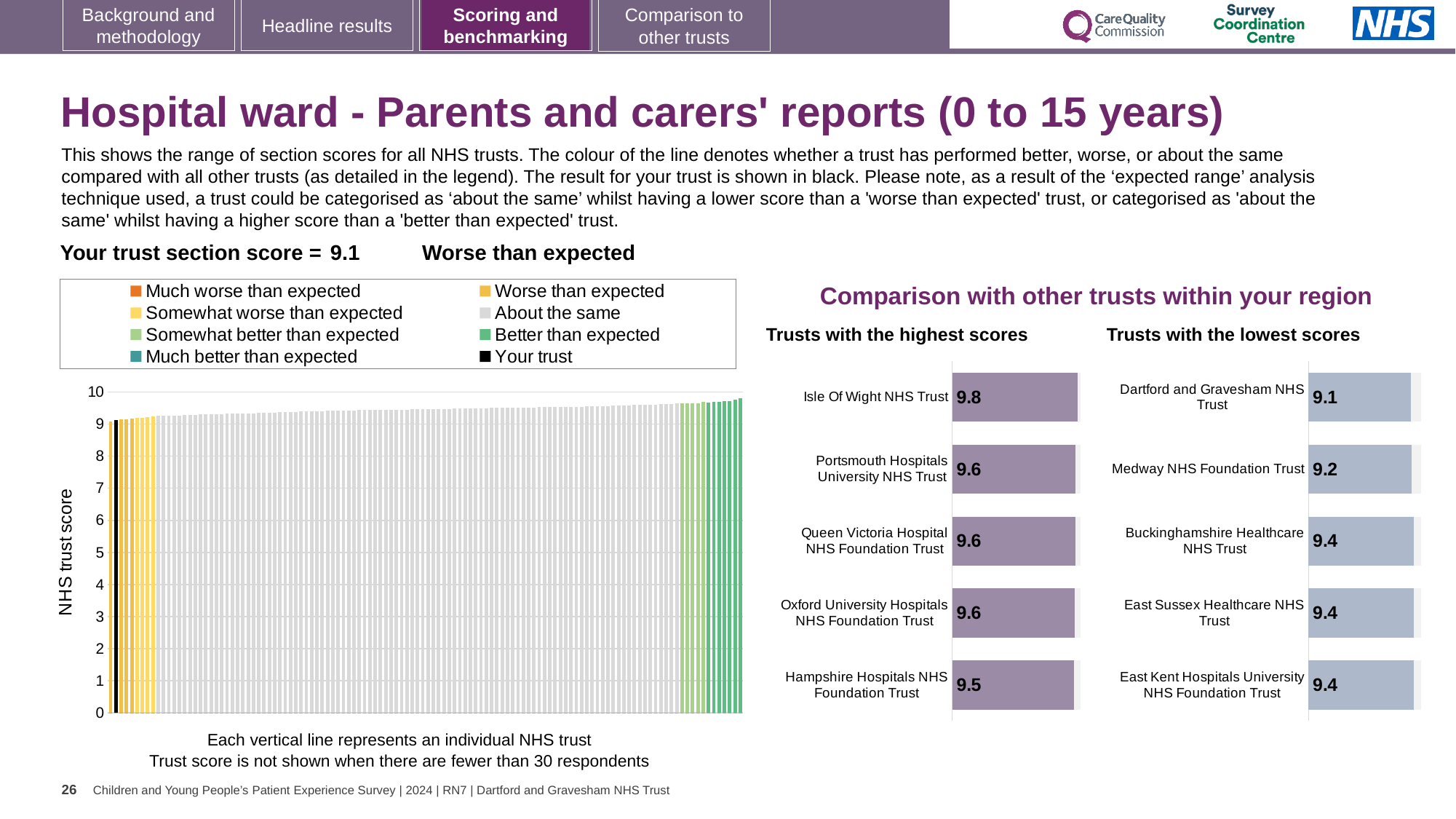
In the 'Trusts with the lowest scores' chart, what is the difference between the scores of East Kent Hospitals University NHS Foundation Trust and Dartford and Gravesham NHS Trust? 0.3 In the 'Trusts with the highest scores' chart, what is the score for Isle Of Wight NHS Trust? 9.8 In the 'Trusts with the lowest scores' chart, which has the larger score: Medway NHS Foundation Trust or Buckinghamshire Healthcare NHS Trust? Buckinghamshire Healthcare NHS Trust In the 'Trusts with the highest scores' chart, which trust has the highest score? Isle Of Wight NHS Trust What is the y-axis label of the large chart on the left? NHS trust score In the 'Trusts with the lowest scores' chart, which trust has the lowest score? Dartford and Gravesham NHS Trust In the large chart on the left, is the value of the black 'Your trust' bar greater or less than 5? greater How many trusts are listed in the 'Trusts with the highest scores' chart? 5 What kind of chart is the large chart on the left showing NHS trust scores? bar chart In the 'Trusts with the lowest scores' chart, what is the score for Medway NHS Foundation Trust? 9.2 In the 'Trusts with the highest scores' chart, what is the difference between the scores of Isle Of Wight NHS Trust and Hampshire Hospitals NHS Foundation Trust? 0.3 How many entries does the legend of the large chart on the left list? 8